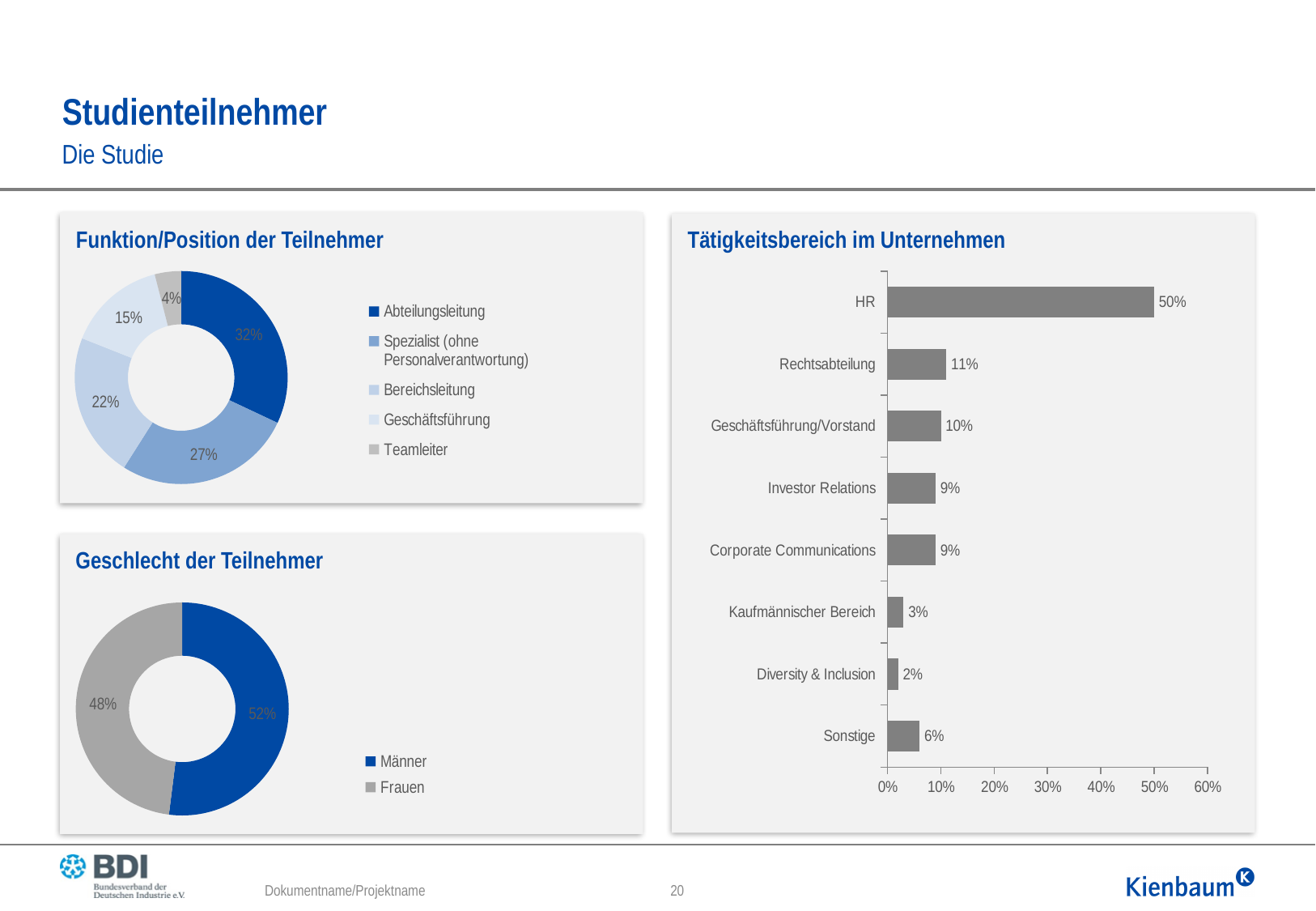
In the 'Funktion/Position der Teilnehmer' chart, how many categories does the legend list? 5 In the 'Geschlecht der Teilnehmer' chart, which is larger, Männer or Frauen? Männer In the 'Tätigkeitsbereich im Unternehmen' chart, which category has the highest value? HR In the 'Geschlecht der Teilnehmer' chart, what share do Frauen have? 48% In the 'Tätigkeitsbereich im Unternehmen' chart, what is the difference between HR and Rechtsabteilung? 39% In the 'Tätigkeitsbereich im Unternehmen' chart, which category has the lowest value? Diversity & Inclusion In the 'Tätigkeitsbereich im Unternehmen' chart, what is the value for HR? 50% In the 'Funktion/Position der Teilnehmer' chart, what share does Abteilungsleitung have? 32% In the 'Tätigkeitsbereich im Unternehmen' chart, how many categories are shown? 8 What kind of chart is 'Tätigkeitsbereich im Unternehmen'? Bar chart In the 'Tätigkeitsbereich im Unternehmen' chart, what is the value for Rechtsabteilung? 11% In the 'Funktion/Position der Teilnehmer' chart, which category has the smallest share? Teamleiter